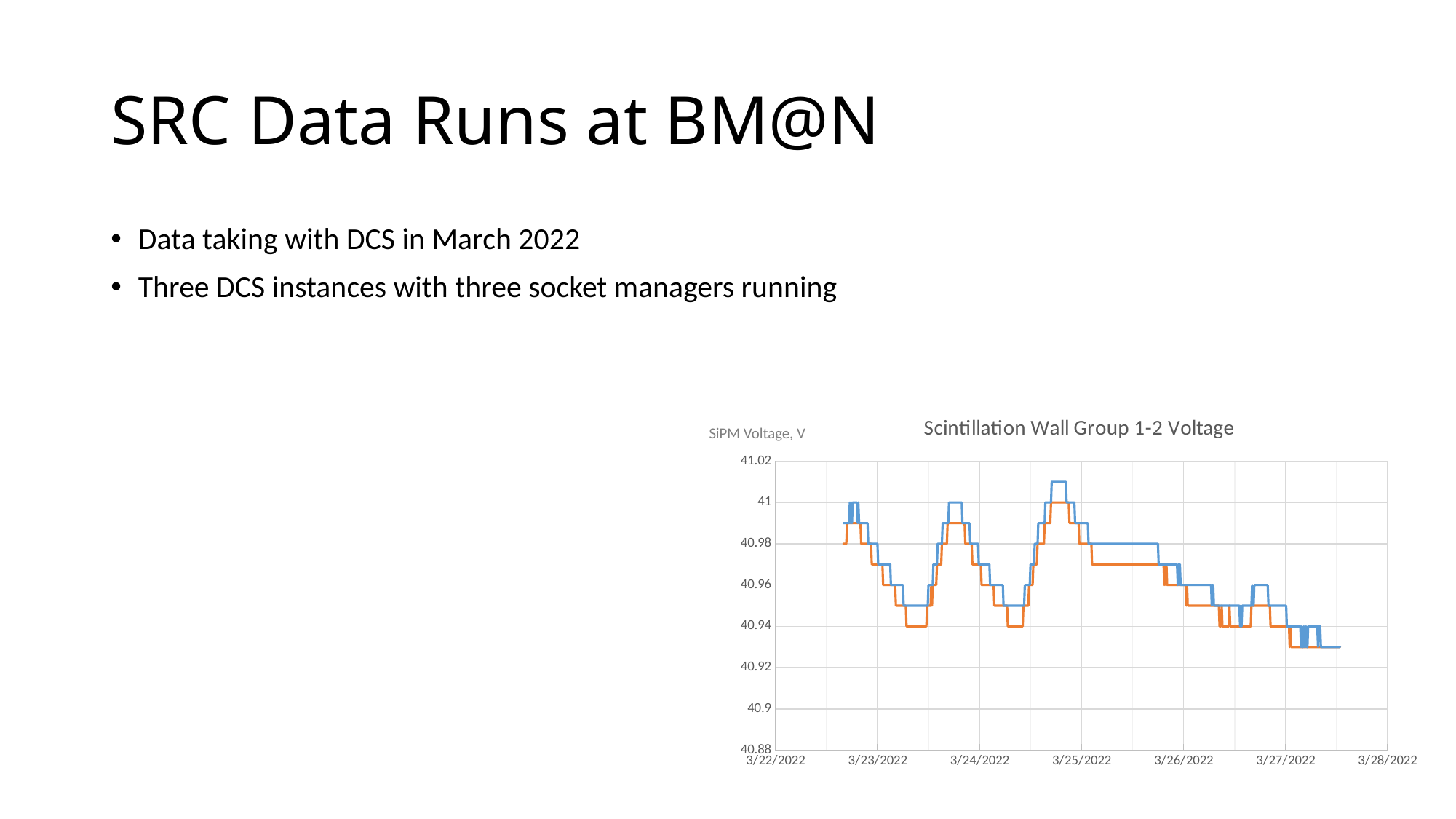
Is the highest peak of the blue line, near 3/25/2022, greater or less than 41? greater Overall, do the voltage values rise or fall from 3/23/2022 to 3/27/2022? fall How many date labels are shown along the x axis? 7 Which of the three peaks reaches the highest voltage: the one near 3/23/2022, near 3/24/2022, or near 3/25/2022? near 3/25/2022 What is the lowest value shown on the vertical axis? 40.88 How many lines are plotted on the chart? 2 What kind of chart is shown on the slide? line chart Is the lowest dip of the orange line between 3/23/2022 and 3/24/2022 greater or less than 40.92? greater Is the voltage at the right end of the lines, after 3/27/2022, greater or less than 40.94? less What is the title of the chart? Scintillation Wall Group 1-2 Voltage What label is shown on the vertical axis of the chart? SiPM Voltage, V